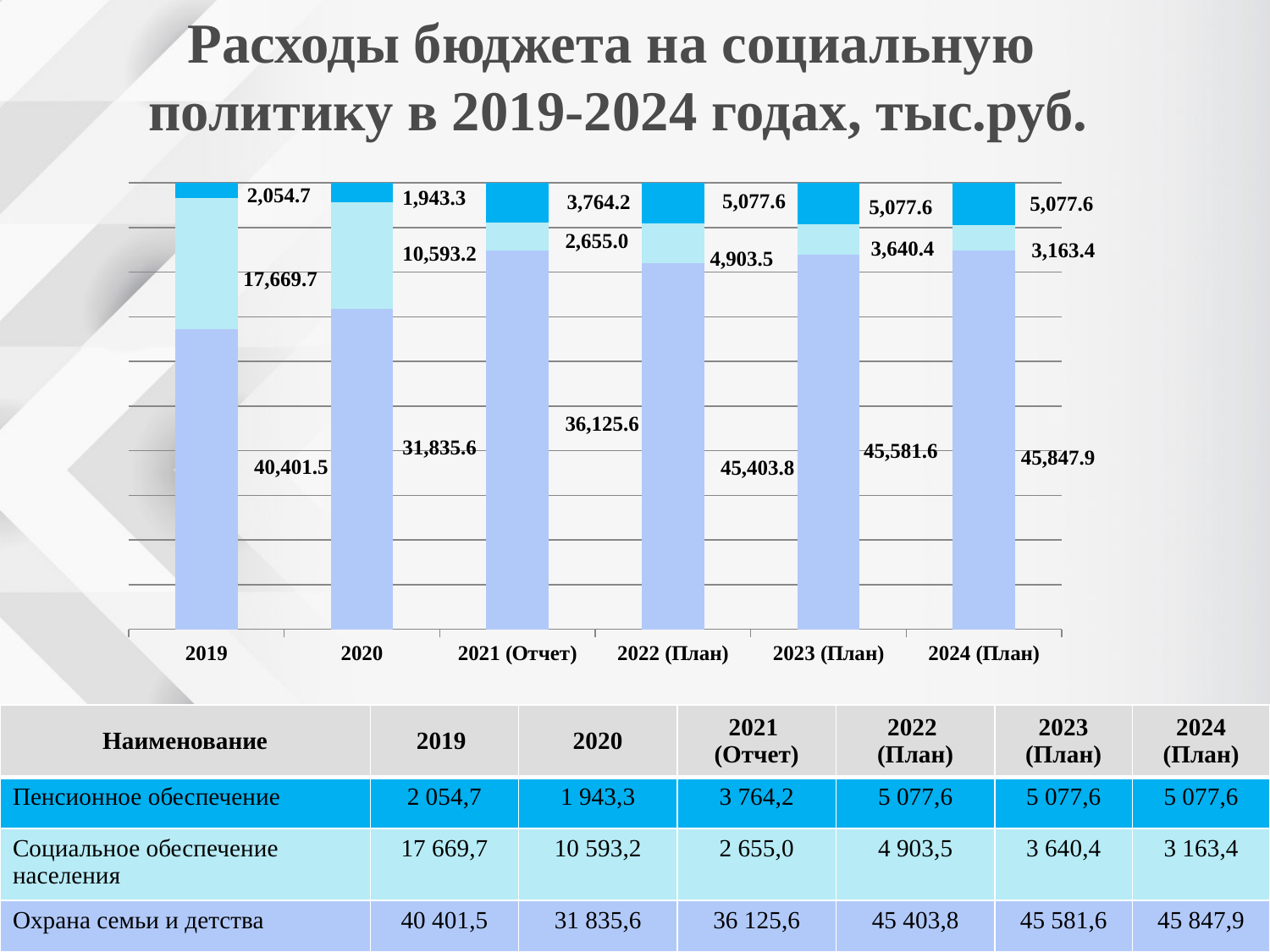
In which year is the value for Охрана семьи и детства the lowest? 2020 What is the value for Пенсионное обеспечение in 2021 (Отчет)? 3,764.2 What is the value for Социальное обеспечение населения in 2023 (План)? 3,640.4 How many series are stacked in each bar? 3 In which year is the value for Социальное обеспечение населения the highest? 2019 Which is larger: Социальное обеспечение населения in 2020 or in 2022 (План)? 2020 How many years (categories) are shown on the x axis? 6 What is the difference between the Охрана семьи и детства values for 2024 (План) and 2019? 5,446.4 What is the total of the stacked bar for 2024 (План)? 54,088.9 What kind of chart is shown on the slide? Stacked bar chart Does the value for Социальное обеспечение населения rise or fall from 2022 (План) to 2024 (План)? Fall What is the value for Охрана семьи и детства in 2019? 40,401.5